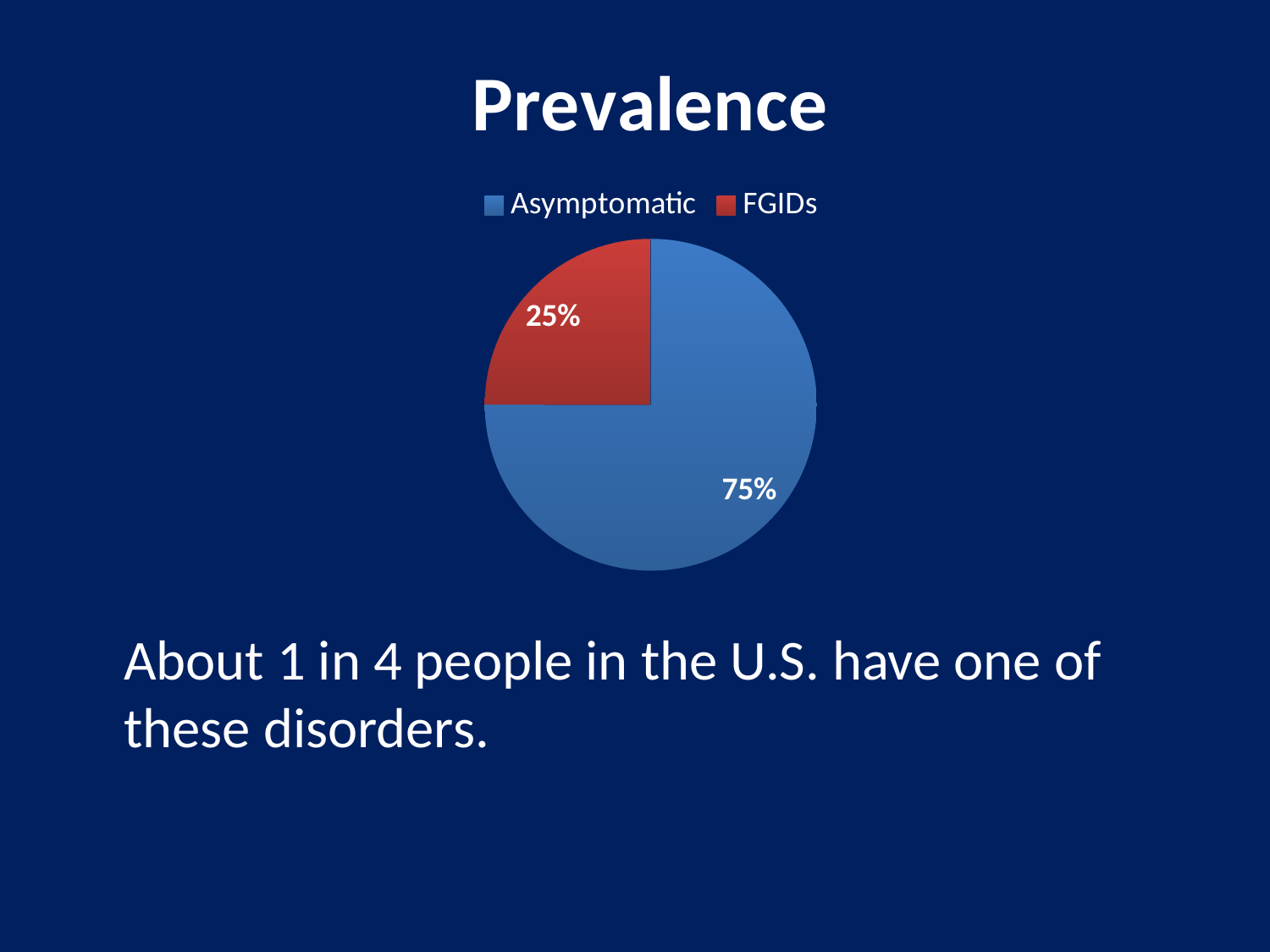
Which is larger, the Asymptomatic slice or the FGIDs slice? Asymptomatic How many entries does the legend list? 2 What is the title of the chart? Prevalence What share of the pie is labelled FGIDs? 25% What kind of chart is shown on the slide? pie chart How many slices does the pie chart have? 2 What colour is the FGIDs slice? red Which slice of the pie is the largest? Asymptomatic What share of the pie is labelled Asymptomatic? 75% What is the difference in percentage points between the Asymptomatic and FGIDs slices? 50 Which slice of the pie is the smallest? FGIDs